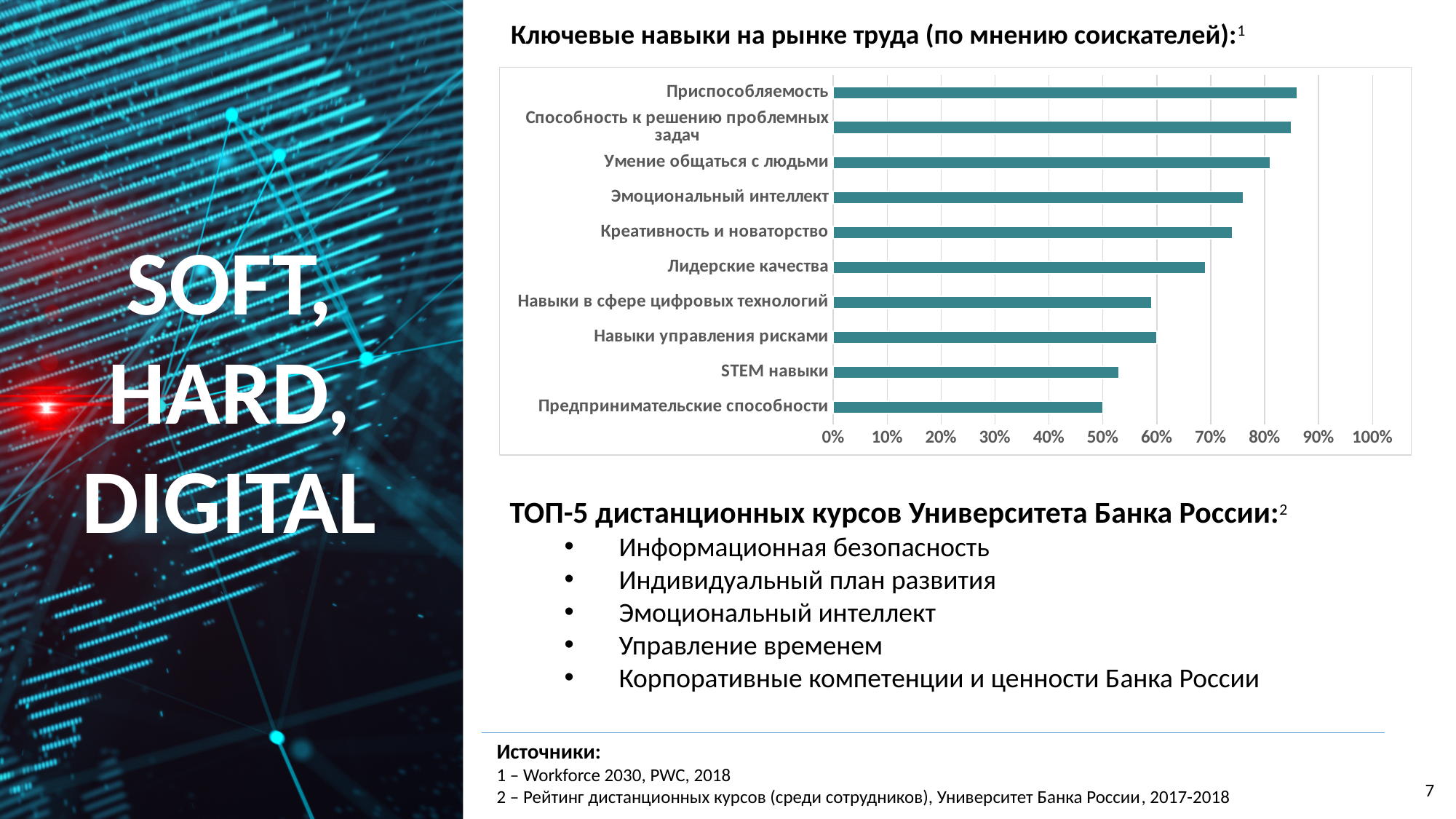
What is the title of the chart? Ключевые навыки на рынке труда (по мнению соискателей) Which skill has the lowest value in the chart? Предпринимательские способности What is the maximum value shown on the chart's horizontal axis? 100% Is the value for Лидерские качества greater or less than 60%? greater Which is larger: the value for Лидерские качества or the value for STEM навыки? Лидерские качества Is the value for Креативность и новаторство greater or less than 70%? greater Is the value for Эмоциональный интеллект greater or less than 70%? greater How many skill categories are plotted in the chart? 10 Which is larger: the value for Эмоциональный интеллект or the value for Навыки управления рисками? Эмоциональный интеллект What kind of chart is shown on the slide? Bar chart